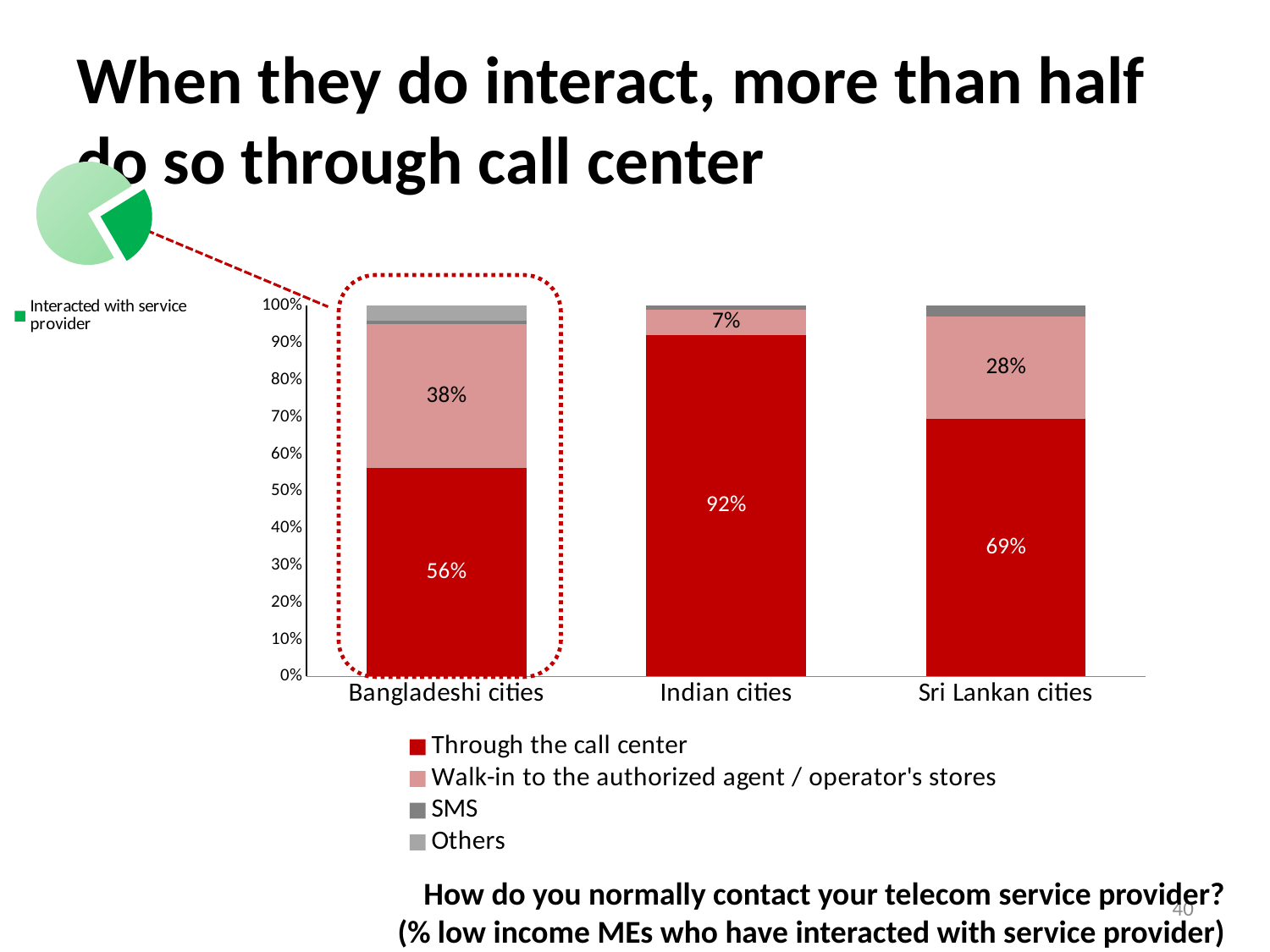
In the stacked bar chart, which has a larger walk-in share: Bangladeshi cities or Sri Lankan cities? Bangladeshi cities In the stacked bar chart, which city group has the highest share contacting the provider through the call center? Indian cities In the stacked bar chart, what percentage of low income MEs in Bangladeshi cities contact their provider through the call center? 56% How many city groups are shown on the x axis of the stacked bar chart? 3 In the stacked bar chart, what is the value for 'Walk-in to the authorized agent / operator's stores' in Sri Lankan cities? 28% In the stacked bar chart, what is the value for 'Through the call center' in Indian cities? 92% In the stacked bar chart, is the SMS value for Bangladeshi cities greater or less than 10%? less What kind of chart is the main chart on the slide? Stacked bar chart In the stacked bar chart, which city group has the lowest share contacting the provider through the call center? Bangladeshi cities In the stacked bar chart, how many percentage points higher is the call center share in Indian cities than in Bangladeshi cities? 36 percentage points How many series does the legend of the stacked bar chart list? 4 In the stacked bar chart, what is the value for 'Walk-in to the authorized agent / operator's stores' in Indian cities? 7%